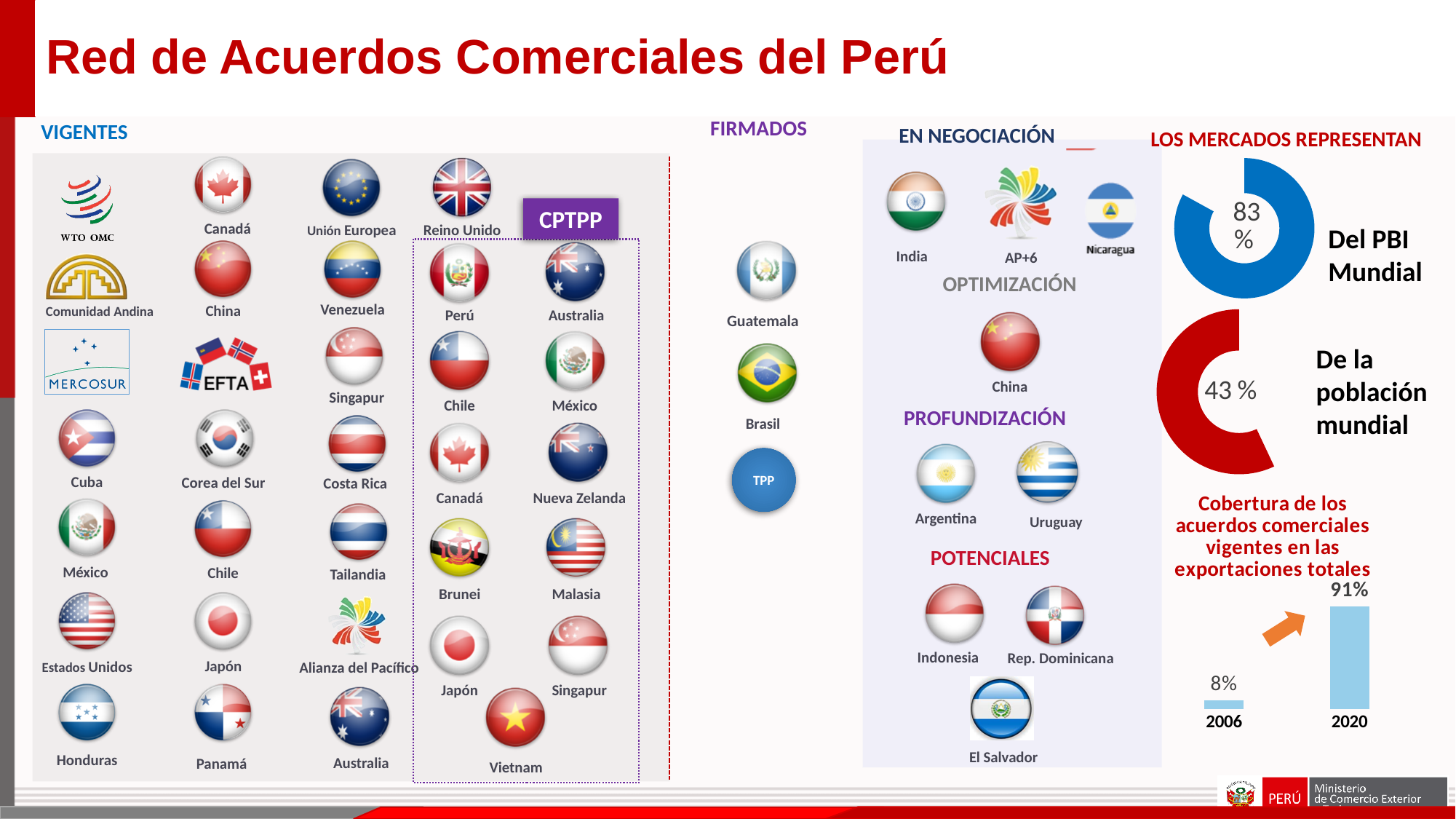
In the bar chart titled 'Cobertura de los acuerdos comerciales vigentes en las exportaciones totales', what is the value for 2006? 8% Under 'LOS MERCADOS REPRESENTAN', which is larger: the share of 'PBI Mundial' or the share of 'población mundial'? PBI Mundial In the bar chart titled 'Cobertura de los acuerdos comerciales vigentes en las exportaciones totales', what is the difference between the 2020 and 2006 values? 83% What colour is the donut chart showing the share of 'PBI Mundial'? blue In the bar chart titled 'Cobertura de los acuerdos comerciales vigentes en las exportaciones totales', do the values rise or fall from 2006 to 2020? rise What kind of chart is the 'Cobertura de los acuerdos comerciales vigentes en las exportaciones totales' chart? bar chart In the bar chart titled 'Cobertura de los acuerdos comerciales vigentes en las exportaciones totales', what is the value for 2020? 91% In the bar chart titled 'Cobertura de los acuerdos comerciales vigentes en las exportaciones totales', how many years are shown? 2 In the bar chart titled 'Cobertura de los acuerdos comerciales vigentes en las exportaciones totales', which year has the lower value? 2006 In the bar chart titled 'Cobertura de los acuerdos comerciales vigentes en las exportaciones totales', which year has the higher value? 2020 In the red donut chart under 'LOS MERCADOS REPRESENTAN', what share of 'población mundial' is shown? 43 % In the blue donut chart under 'LOS MERCADOS REPRESENTAN', what share of 'PBI Mundial' is shown? 83%